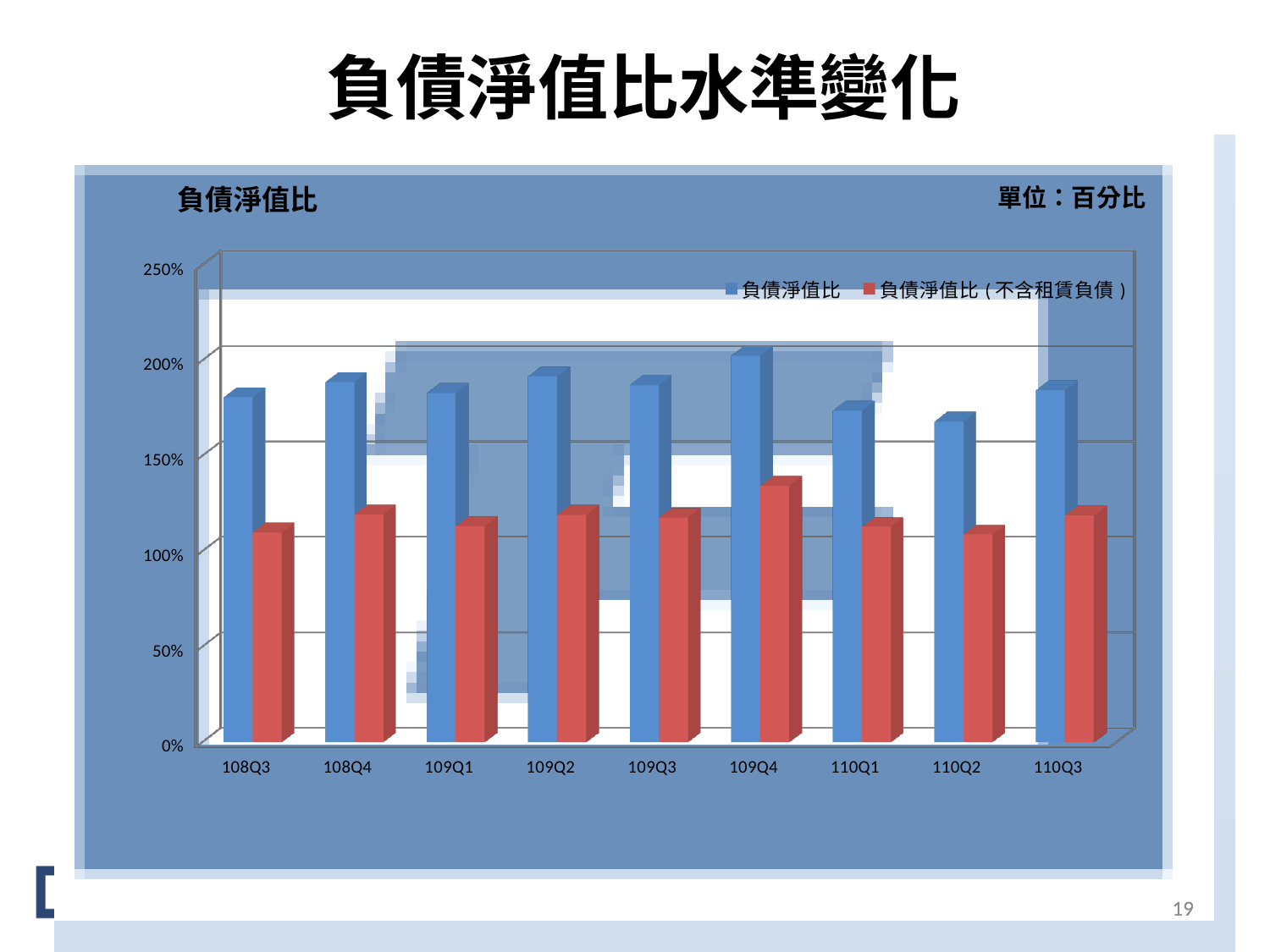
How many series does the legend list? 2 What kind of chart is shown on the slide? bar chart Is the 負債淨值比 value for 108Q3 greater or less than 150%? greater Is the 負債淨值比 value for 110Q2 greater or less than 200%? less Is the 負債淨值比（不含租賃負債）value for 108Q3 greater or less than 150%? less Which is larger for 負債淨值比: the value for 109Q4 or the value for 110Q2? 109Q4 In 109Q2, which series is larger: 負債淨值比 or 負債淨值比（不含租賃負債）? 負債淨值比 Which quarter has the highest value for 負債淨值比（不含租賃負債）(red bars)? 109Q4 How many quarters (categories) are shown on the x axis? 9 Which quarter has the highest value for 負債淨值比 (blue bars)? 109Q4 What unit is stated at the top right of the chart? 百分比